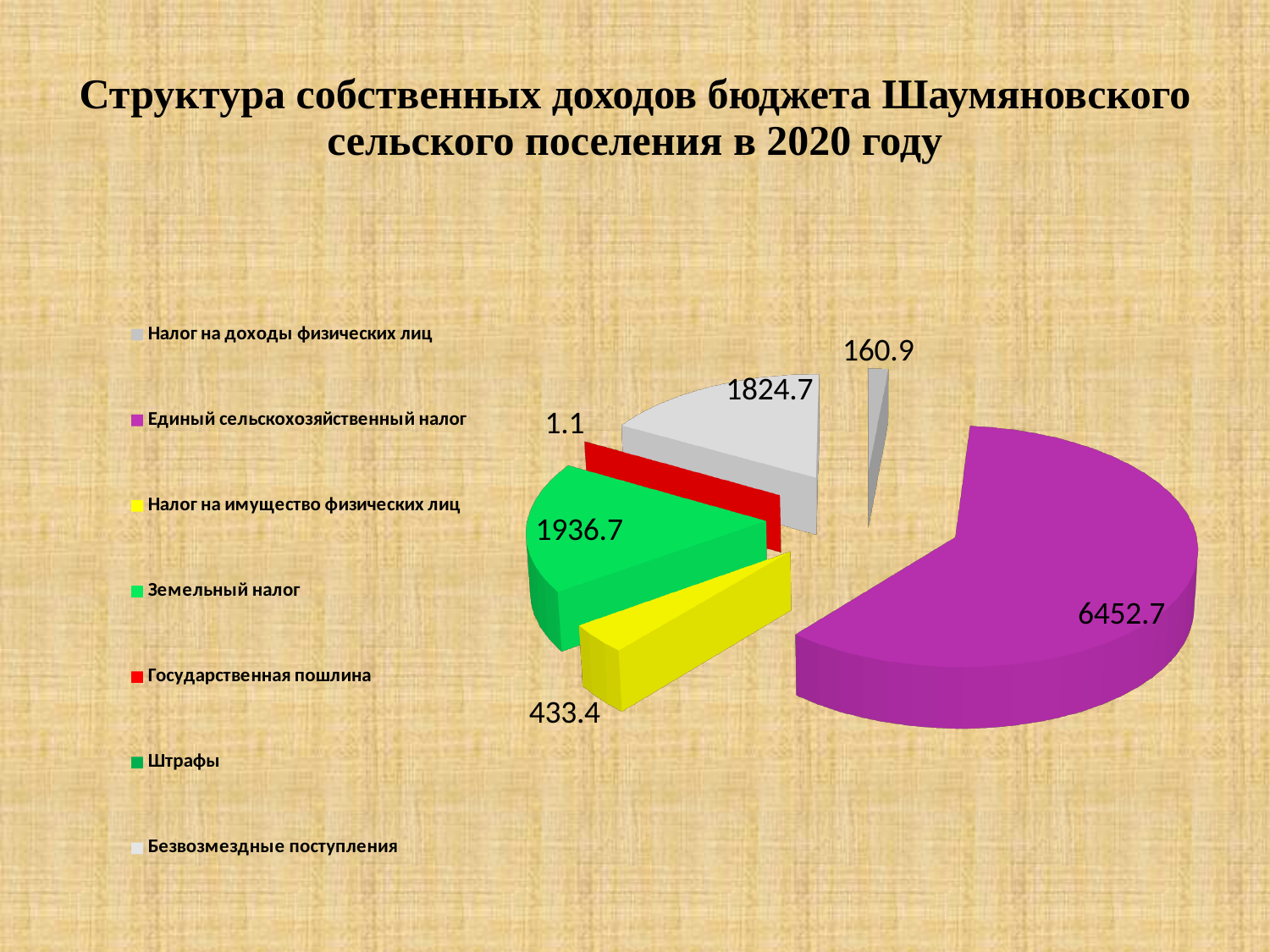
What is the difference between the values for Налог на доходы физических лиц and Налог на имущество физических лиц? 272.5 What is the value for Единый сельскохозяйственный налог? 6452.7 What kind of chart is shown on the slide? pie chart What is the value for Налог на доходы физических лиц? 160.9 Which is larger: Налог на имущество физических лиц or Государственная пошлина? Налог на имущество физических лиц How many entries does the legend list? 7 Which labelled category has the smallest value? Государственная пошлина What is the value for Налог на имущество физических лиц? 433.4 What is the value for Государственная пошлина? 1.1 What is the value for Безвозмездные поступления? 1824.7 Which category has the largest slice of the pie? Единый сельскохозяйственный налог What is the difference between the values for Единый сельскохозяйственный налог and Налог на доходы физических лиц? 6291.8